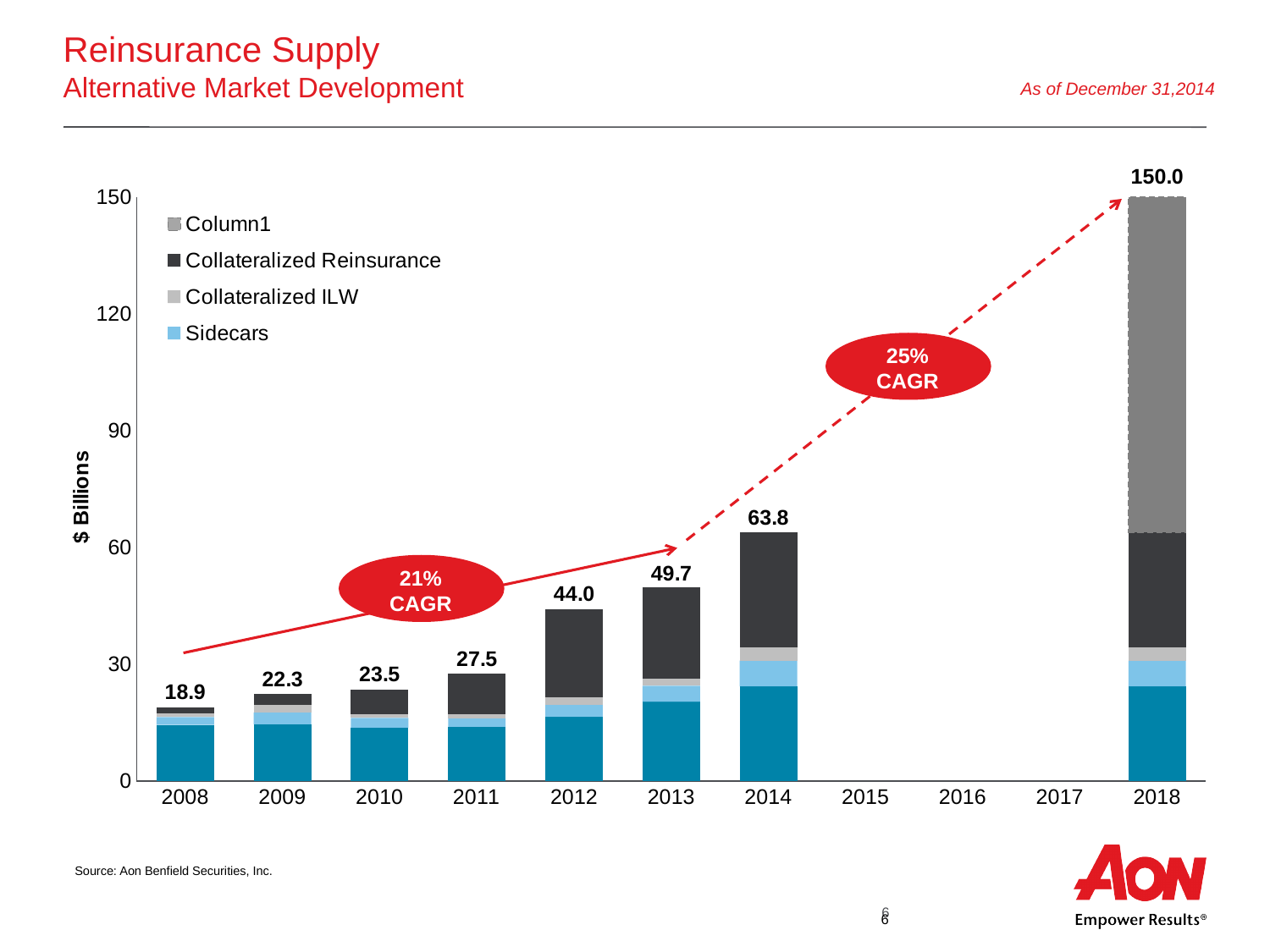
What is the total value shown for 2014? 63.8 What is the total value shown for 2018? 150.0 How many series does the legend list? 4 How many years have bars plotted on the chart? 8 Which year has the highest total bar? 2018 Which year has a larger total, 2011 or 2012? 2012 What kind of chart is shown on the slide? Stacked bar chart What is the label on the y axis? $ Billions Which year has the lowest total bar? 2008 Is the total for 2013 greater or less than 60? less What is the total value shown for 2008? 18.9 What is the difference between the 2014 total and the 2013 total? 14.1